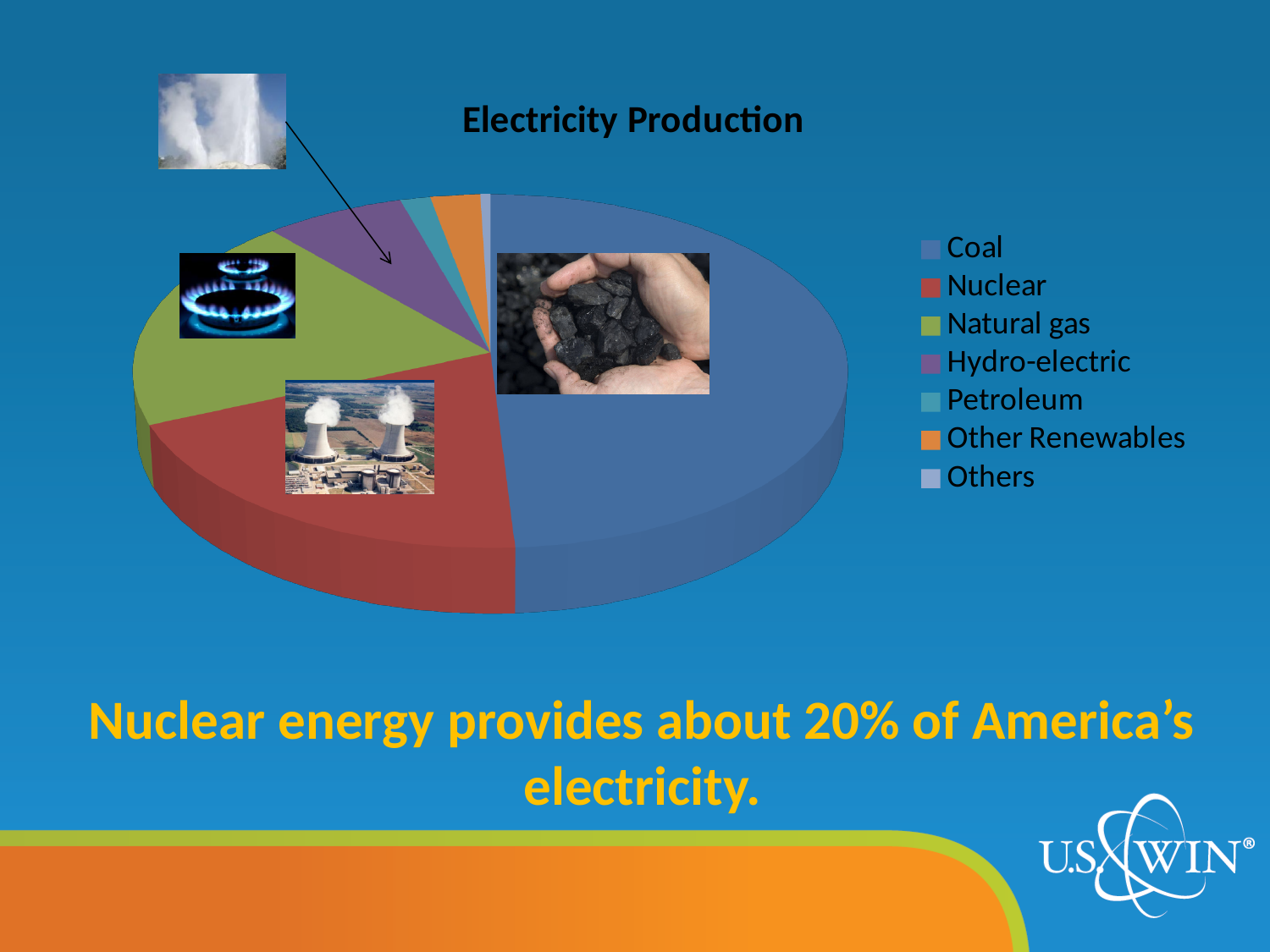
Which slice is larger, Hydro-electric or Petroleum? Hydro-electric How many categories does the pie chart's legend list? 7 Which slice is larger, Coal or Hydro-electric? Coal Which category is shown in red in the legend? Nuclear Which slice is larger, Hydro-electric or Natural gas? Natural gas Which category is listed last in the legend? Others What is the title of the chart? Electricity Production Which category has the largest slice of the pie? Coal What kind of chart is shown on the slide? Pie chart Which category has the smallest slice of the pie? Others